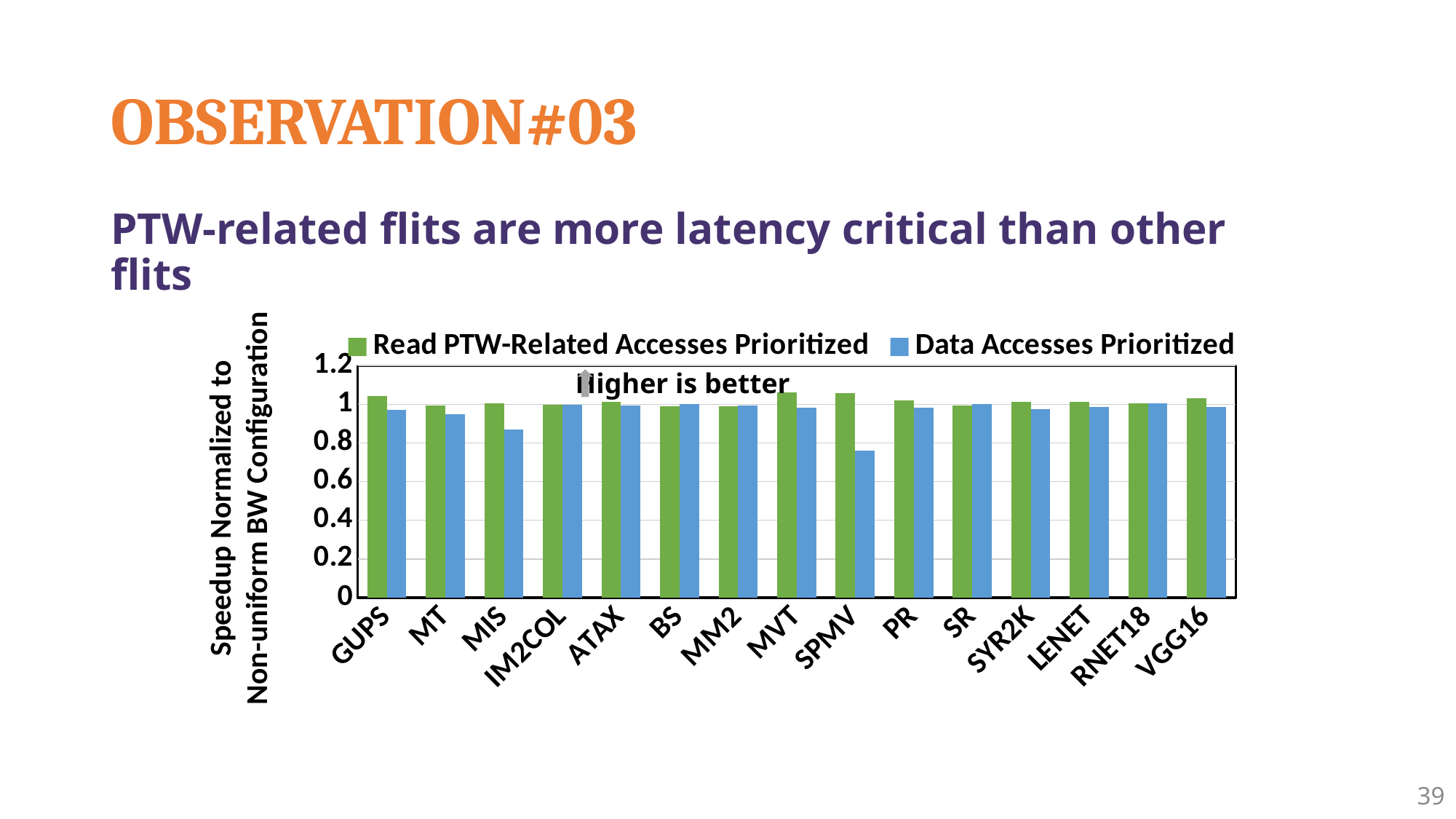
Is the Data Accesses Prioritized value for MVT greater or less than 0.8? greater Which series is shown in green in the chart? Read PTW-Related Accesses Prioritized Which category has the lowest value for the Data Accesses Prioritized series? SPMV Is the Data Accesses Prioritized value for SPMV greater or less than 0.8? less Is the Data Accesses Prioritized value for MIS greater or less than 0.8? greater For MIS, which series has the larger value: Read PTW-Related Accesses Prioritized or Data Accesses Prioritized? Read PTW-Related Accesses Prioritized How many series does the chart legend list? 2 How many workload categories are shown along the x axis of the chart? 15 What is the label of the y axis of the chart? Speedup Normalized to Non-uniform BW Configuration What kind of chart is shown on the slide? bar chart For SPMV, which series has the larger value: Read PTW-Related Accesses Prioritized or Data Accesses Prioritized? Read PTW-Related Accesses Prioritized